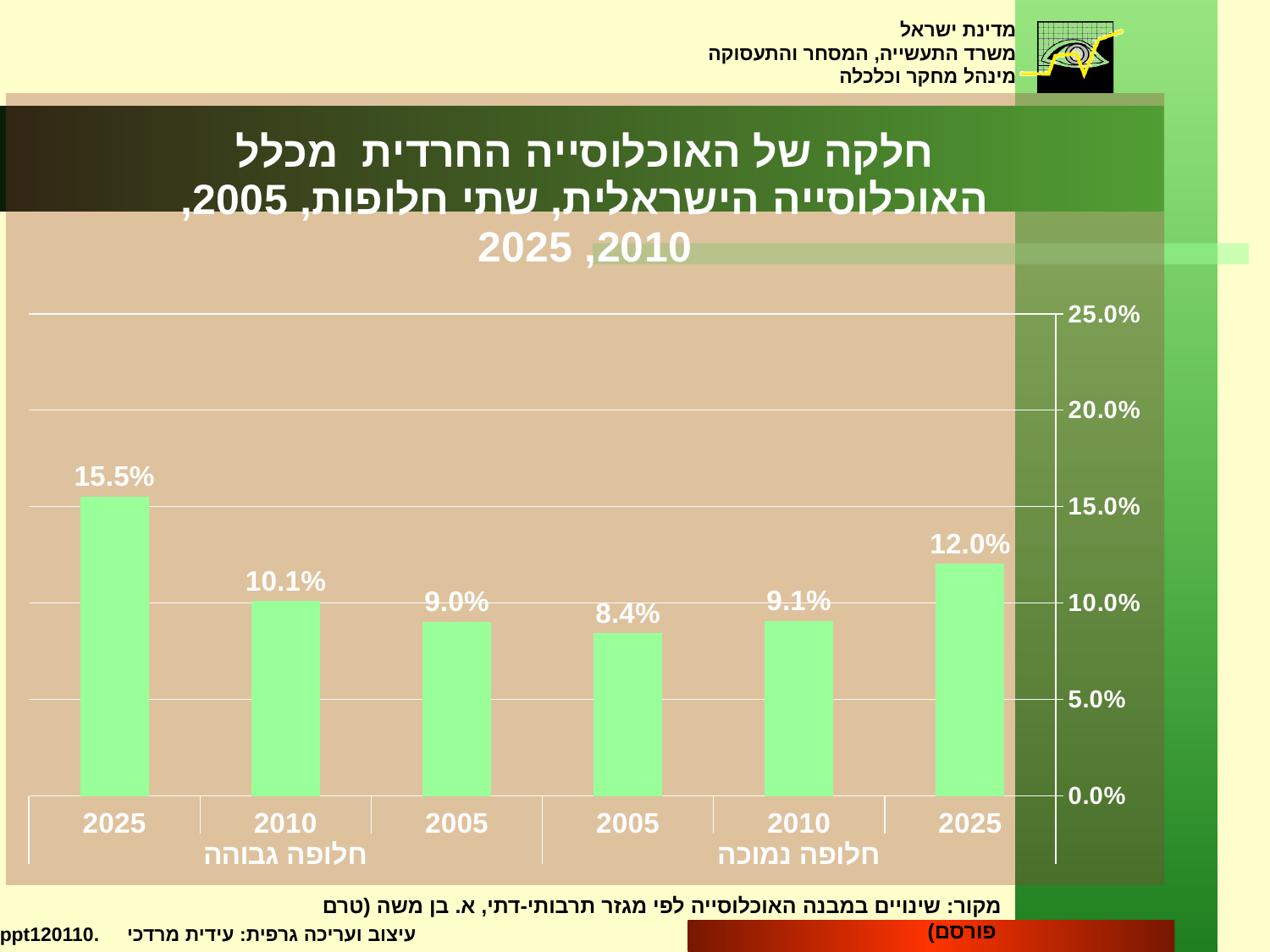
What is the difference between the 2025 values of חלופה גבוהה and חלופה נמוכה? 3.5% Which is larger: the 2010 value under חלופה גבוהה or the 2010 value under חלופה נמוכה? חלופה גבוהה Which bar has the lowest value? 2005, חלופה נמוכה What is the value for 2010 under חלופה נמוכה? 9.1% Is the value for 2005 under חלופה גבוהה greater or less than 10.0%? less Which bar has the highest value? 2025, חלופה גבוהה What kind of chart is shown on the slide? bar chart What is the highest value shown on the vertical axis? 25.0% What is the value for 2025 under חלופה גבוהה? 15.5% How many bars are plotted in the chart? 6 What is the value for 2005 under חלופה נמוכה? 8.4% What is the value for 2025 under חלופה נמוכה? 12.0%